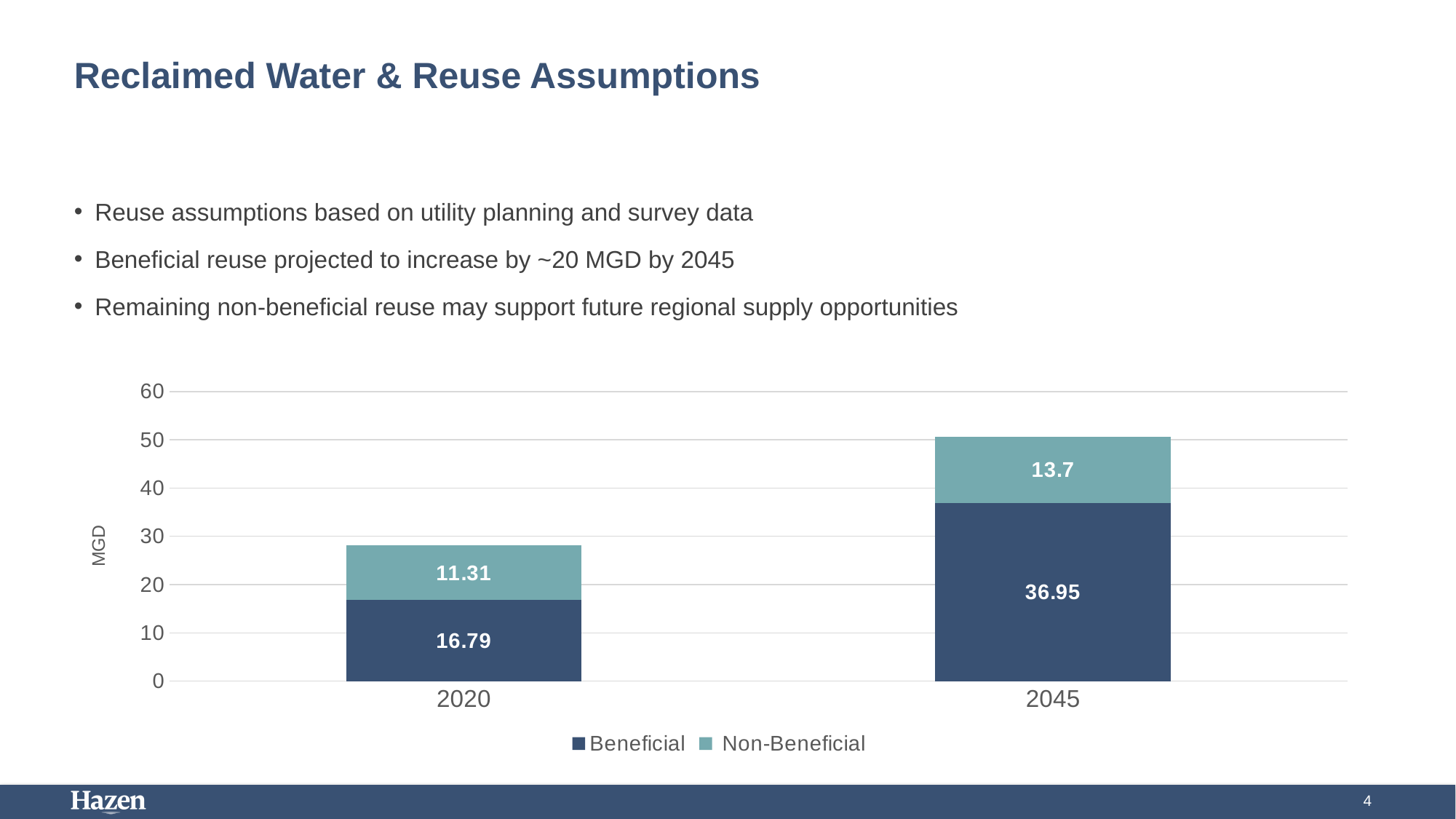
What is the Beneficial value for 2045? 36.95 How many series does the legend list? 2 What kind of chart is shown on the slide? Stacked bar chart What is the Non-Beneficial value for 2020? 11.31 Which year has the larger Non-Beneficial value, 2020 or 2045? 2045 What is the difference between the Beneficial and Non-Beneficial values in 2045? 23.25 By how much does the Beneficial value increase from 2020 to 2045? 20.16 What unit is shown on the y-axis label of the chart? MGD What is the total height of the stacked bar for 2045? 50.65 What is the Non-Beneficial value for 2045? 13.7 What is the Beneficial value for 2020? 16.79 What is the total height of the stacked bar for 2020? 28.1